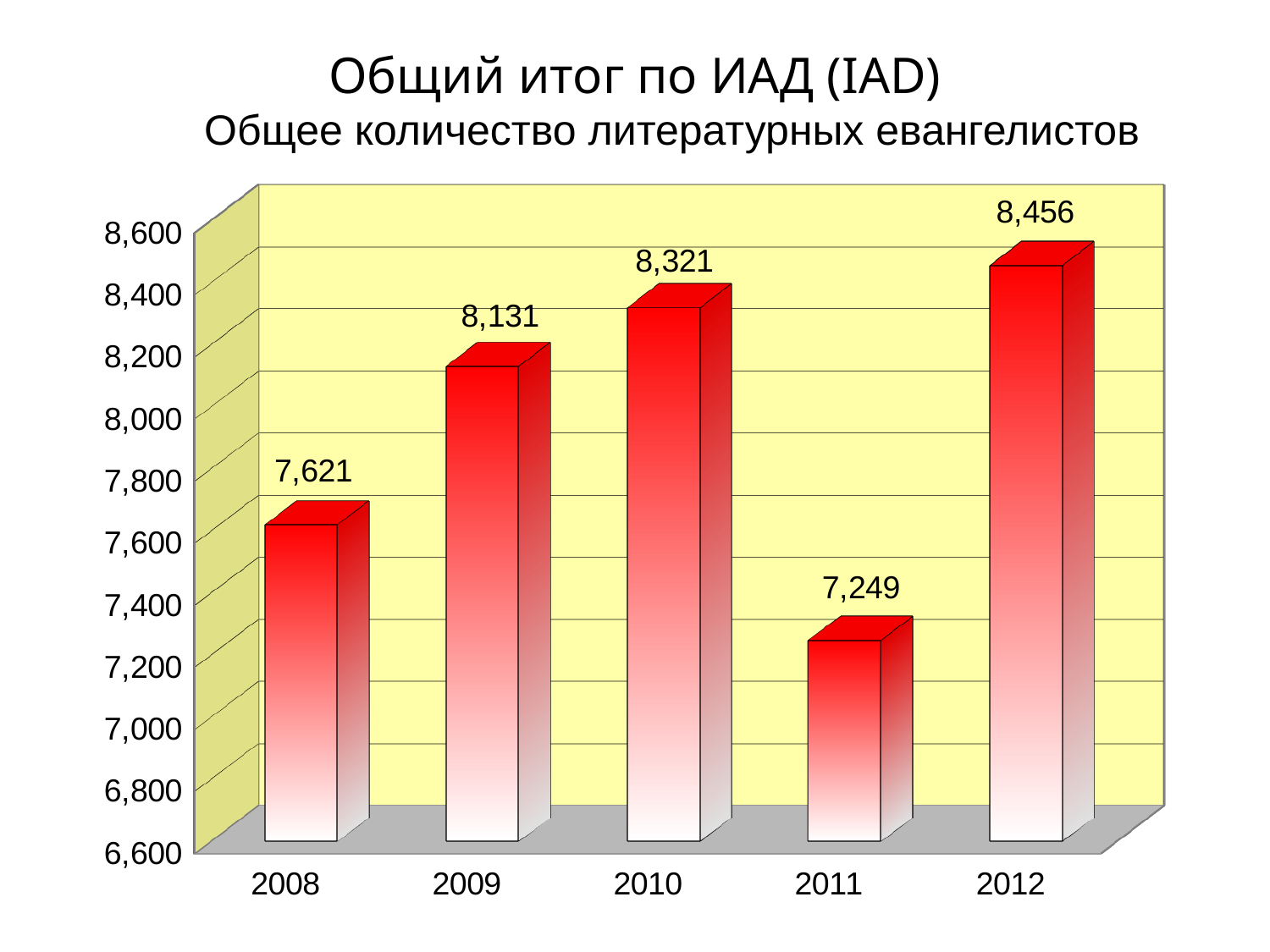
What is the difference between the values for 2010 and 2009? 190 What kind of chart is shown on the slide? bar chart Is the value for 2011 greater or less than 7,400? less Does the value rise or fall from 2010 to 2011? fall Which year has the highest value? 2012 What is the difference between the values for 2012 and 2011? 1,207 Which is larger, the value for 2009 or the value for 2010? 2010 What is the value for 2008? 7,621 What is the value for 2011? 7,249 How many years are shown on the x axis? 5 Which year has the lowest value? 2011 What is the value for 2012? 8,456